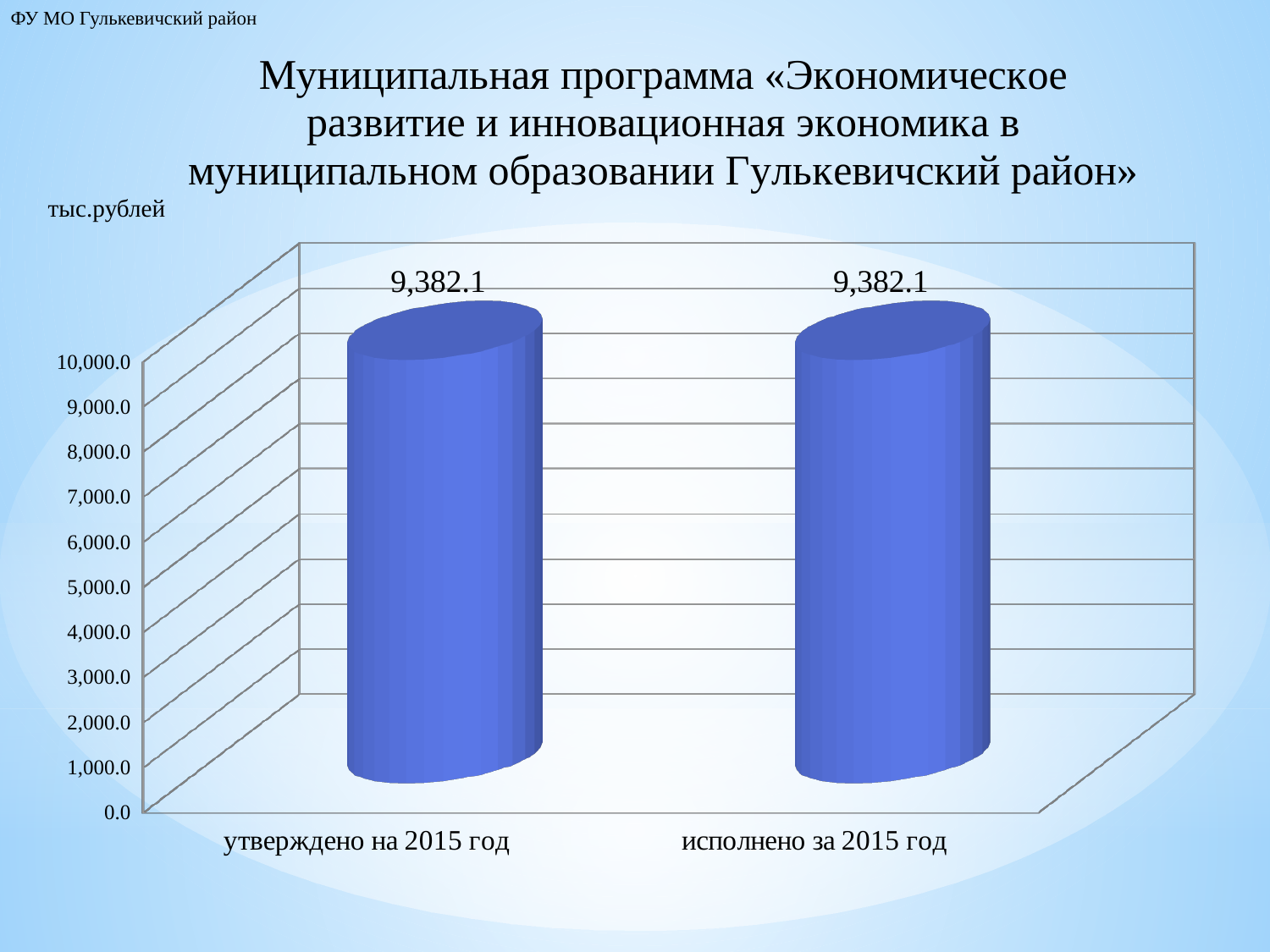
What is the value for «утверждено на 2015 год»? 9,382.1 What is the highest value shown on the vertical axis? 10,000.0 What kind of chart is shown on the slide? bar chart What is the value for «исполнено за 2015 год»? 9,382.1 Is the value for «утверждено на 2015 год» greater or less than 10,000.0? less Are the values for «утверждено на 2015 год» and «исполнено за 2015 год» equal? Yes How many categories are shown on the chart? 2 What is the difference between the values for «утверждено на 2015 год» and «исполнено за 2015 год»? 0.0 What unit of measurement is indicated above the chart? тыс.рублей Is the value for «исполнено за 2015 год» greater or less than 9,000.0? greater